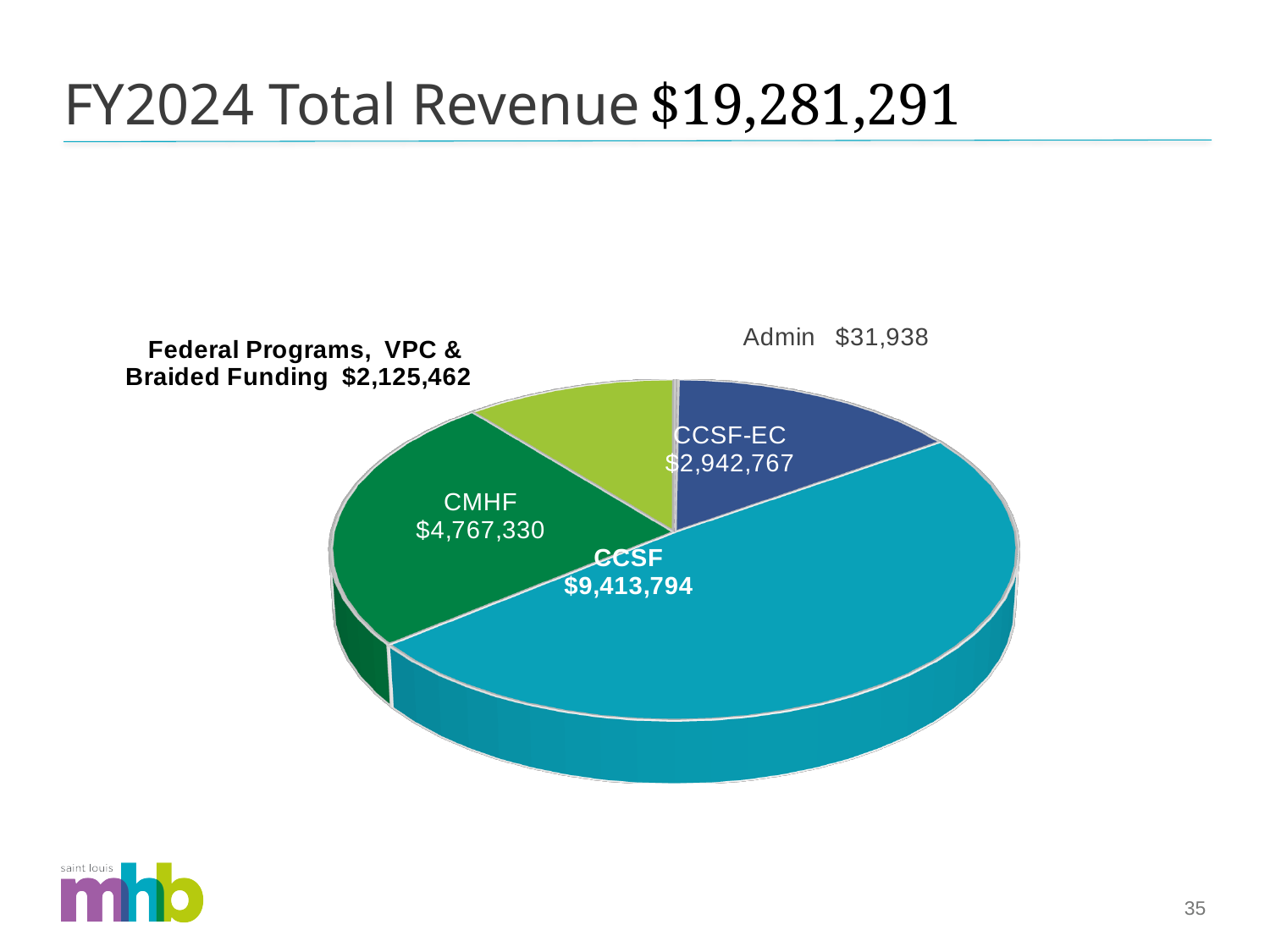
What is the difference between the CCSF and CMHF values? $4,646,464 What is the revenue value for Admin? $31,938 What is the revenue value for CCSF-EC? $2,942,767 What is the revenue value for Federal Programs, VPC & Braided Funding? $2,125,462 How many slices does the pie chart have? 5 What kind of chart is shown on the slide? Pie chart Which category has the smallest slice of the pie? Admin What total revenue is stated in the slide title? $19,281,291 Which category has the largest slice of the pie? CCSF Which is larger, CMHF or CCSF-EC? CMHF What is the revenue value for CMHF? $4,767,330 What is the revenue value for CCSF? $9,413,794